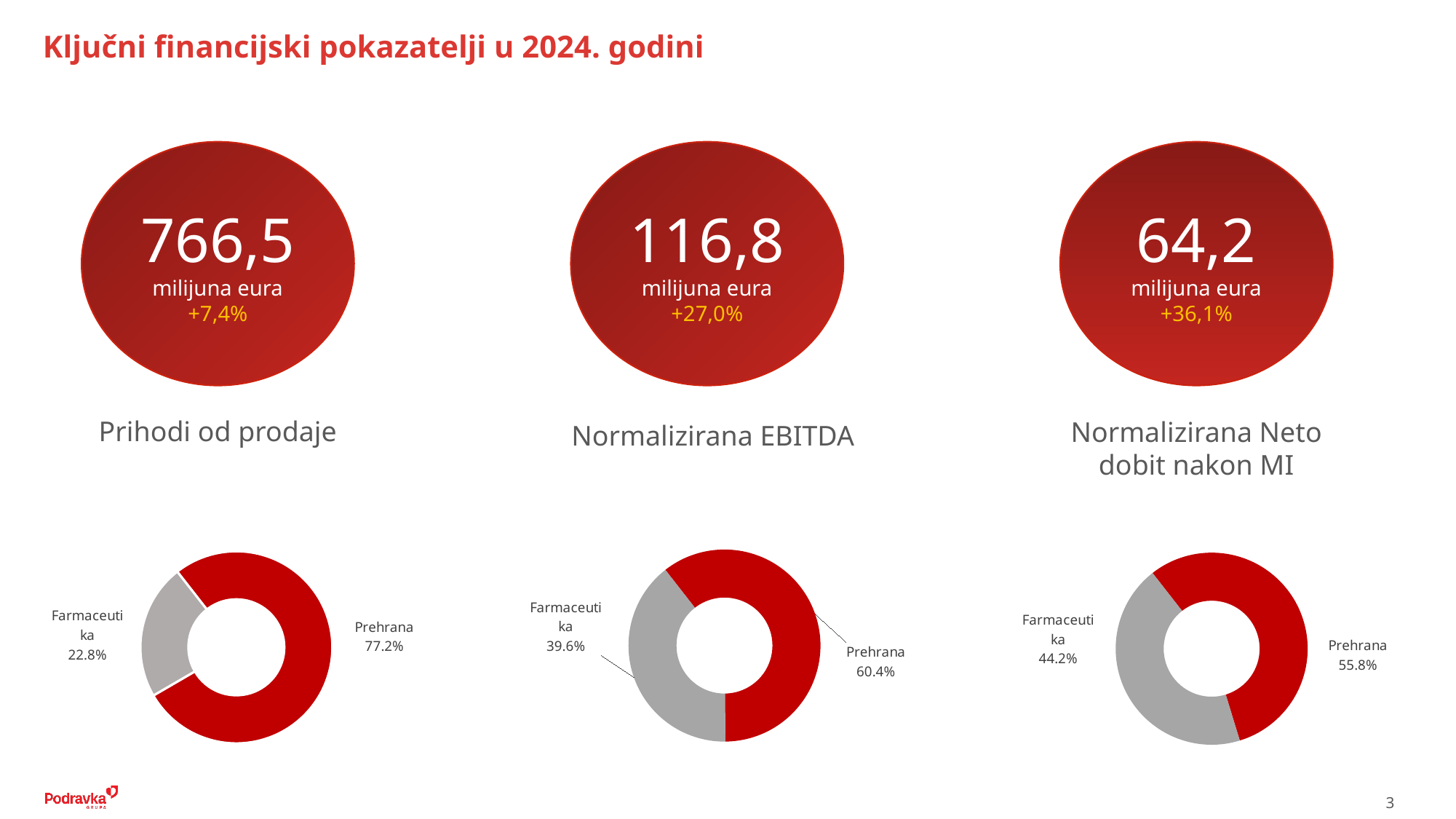
In the right donut chart, which category has the smallest share? Farmaceutika In the right donut chart, what is the share for Prehrana? 55.8% In the middle donut chart, what is the share for Farmaceutika? 39.6% In the left donut chart, what is the share for Prehrana? 77.2% In the left donut chart, what is the share for Farmaceutika? 22.8% In the right donut chart, what is the share for Farmaceutika? 44.2% In the middle donut chart, what is the difference between the Prehrana and Farmaceutika shares? 20.8 percentage points What type of chart is the middle chart at the bottom of the slide? Donut chart In the left donut chart, which category has the largest share? Prehrana How many categories does the left donut chart show? 2 In the middle donut chart, what is the share for Prehrana? 60.4% In the right donut chart, which is larger, Prehrana or Farmaceutika? Prehrana